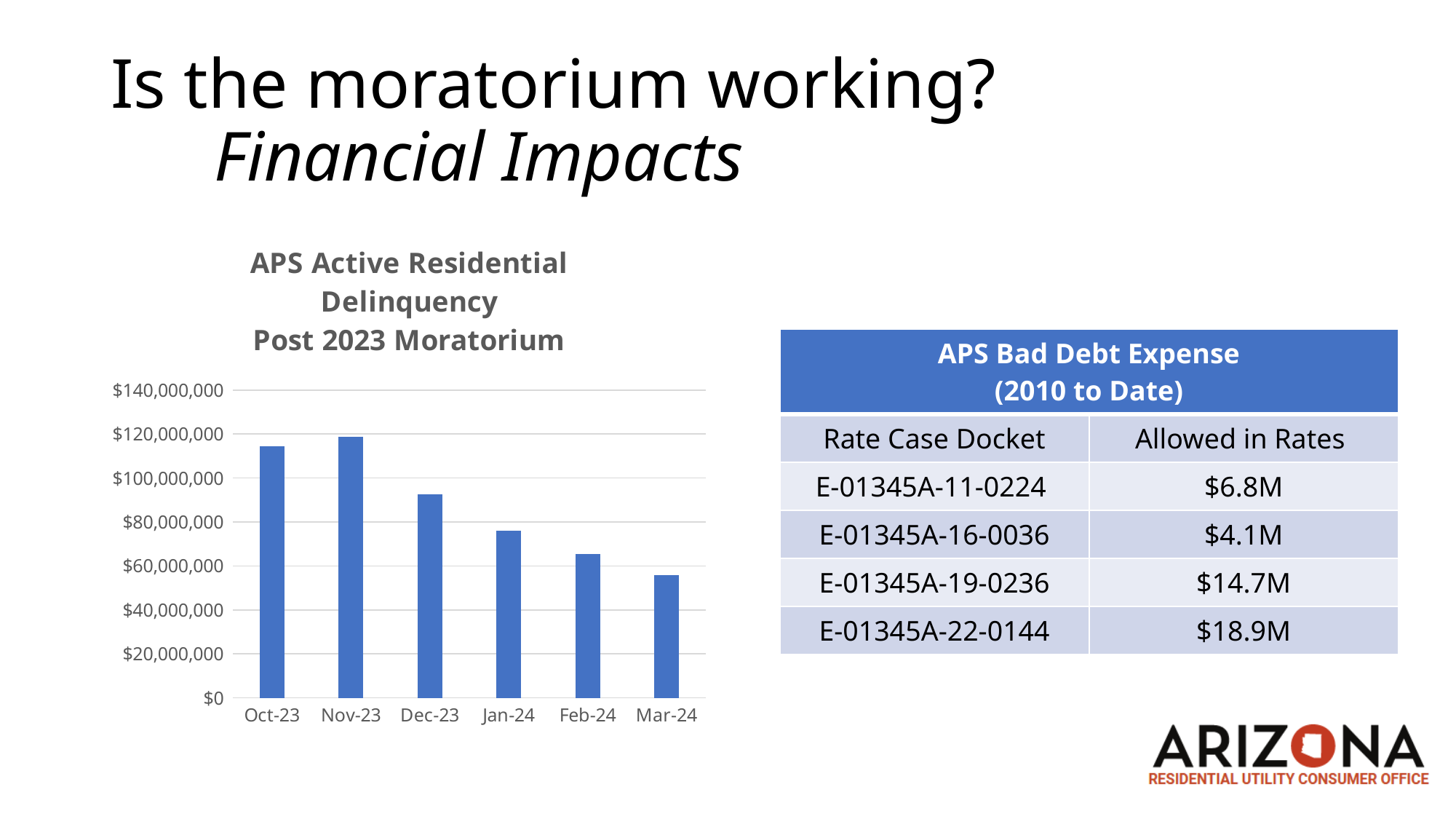
Which is larger, the value for Dec-23 or the value for Jan-24? Dec-23 Is the value for Feb-24 greater or less than $60,000,000? greater What is the title of the chart on the slide? APS Active Residential Delinquency Post 2023 Moratorium Is the value for Mar-24 greater or less than $60,000,000? less Is the value for Dec-23 greater or less than $100,000,000? less From Nov-23 to Mar-24, do the delinquency values rise or fall? fall What kind of chart is shown on the slide? bar chart How many months are plotted in the APS Active Residential Delinquency chart? 6 Which month has the highest delinquency value in the chart? Nov-23 Which month has the lowest delinquency value in the chart? Mar-24